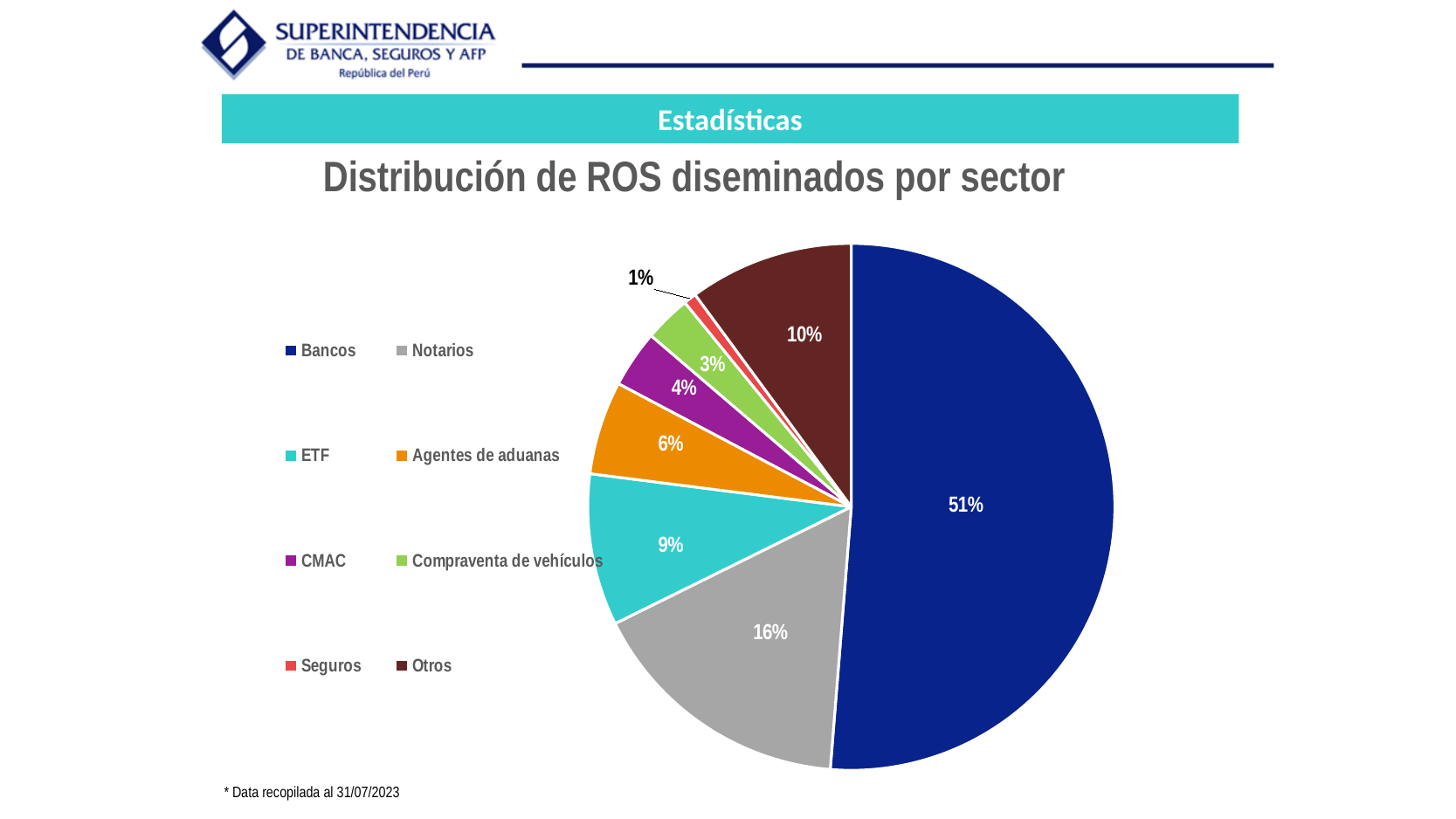
Which sector has the smallest share of the pie? Seguros What percentage is shown for Notarios? 16% What type of chart is shown on the slide? Pie chart What share of the pie does Bancos represent? 51% Which sector has the largest share of the pie? Bancos What percentage is shown for Otros? 10% How many sectors are listed in the legend? 8 What percentage is shown for Agentes de aduanas? 6% What is the title of the chart? Distribución de ROS diseminados por sector What is the difference in percentage points between Notarios and ETF? 7 What percentage is shown for ETF? 9% Which has a larger share, CMAC or Compraventa de vehículos? CMAC